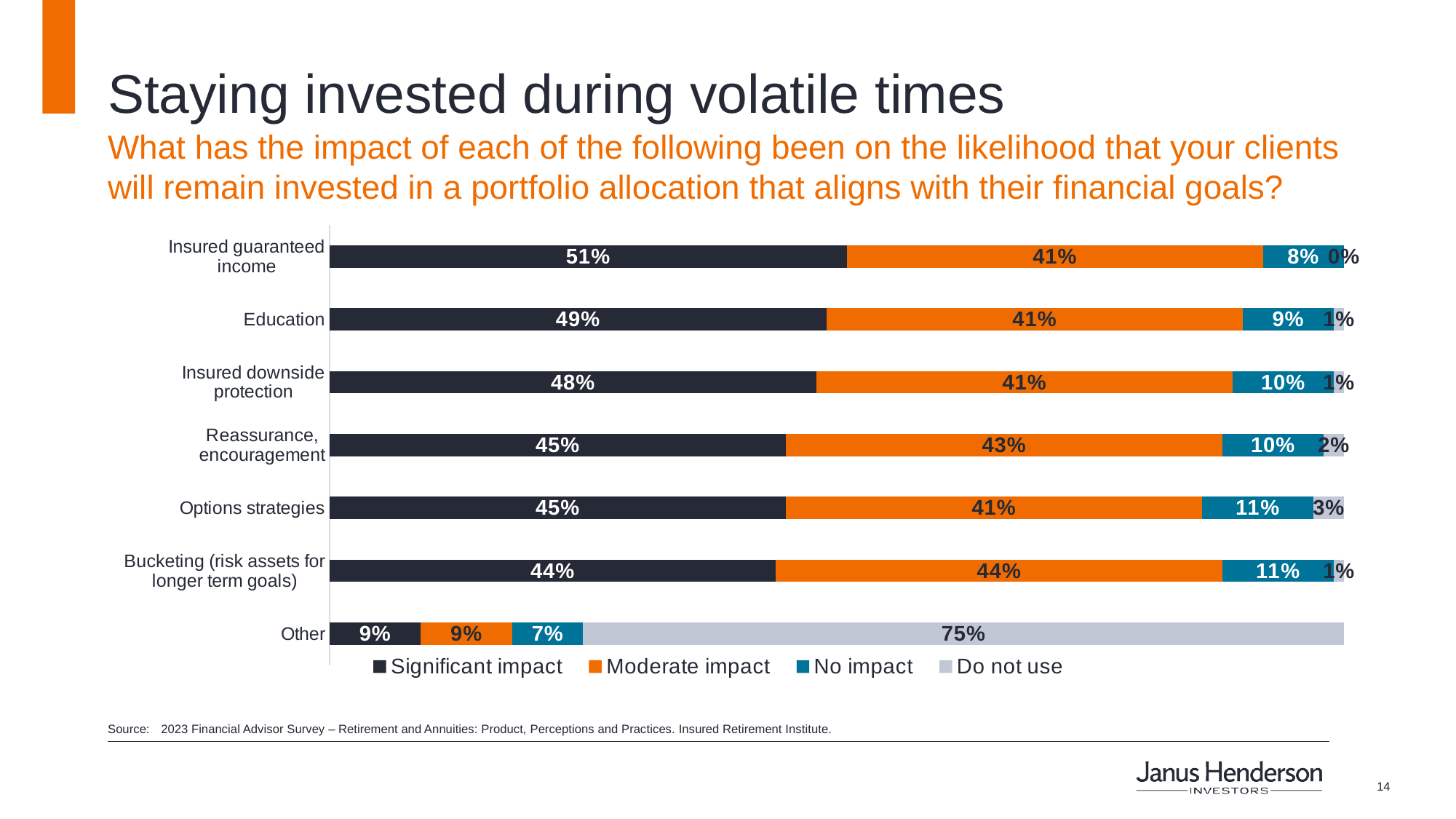
What is the Moderate impact value for Reassurance, encouragement? 43% Which category has the lowest Significant impact value? Other What is the No impact value for Options strategies? 11% How many categories are shown on the chart? 7 What is the total of the Significant impact, Moderate impact and No impact values for Other? 25% What is the Do not use value for Other? 75% Which is larger, the Moderate impact value for Bucketing (risk assets for longer term goals) or for Options strategies? Bucketing (risk assets for longer term goals) What is the Significant impact value for Insured guaranteed income? 51% What kind of chart is shown on the slide? Stacked bar chart What is the difference between the Significant impact values for Insured guaranteed income and Education? 2% Which category has the highest Significant impact value? Insured guaranteed income How many series does the legend list? 4